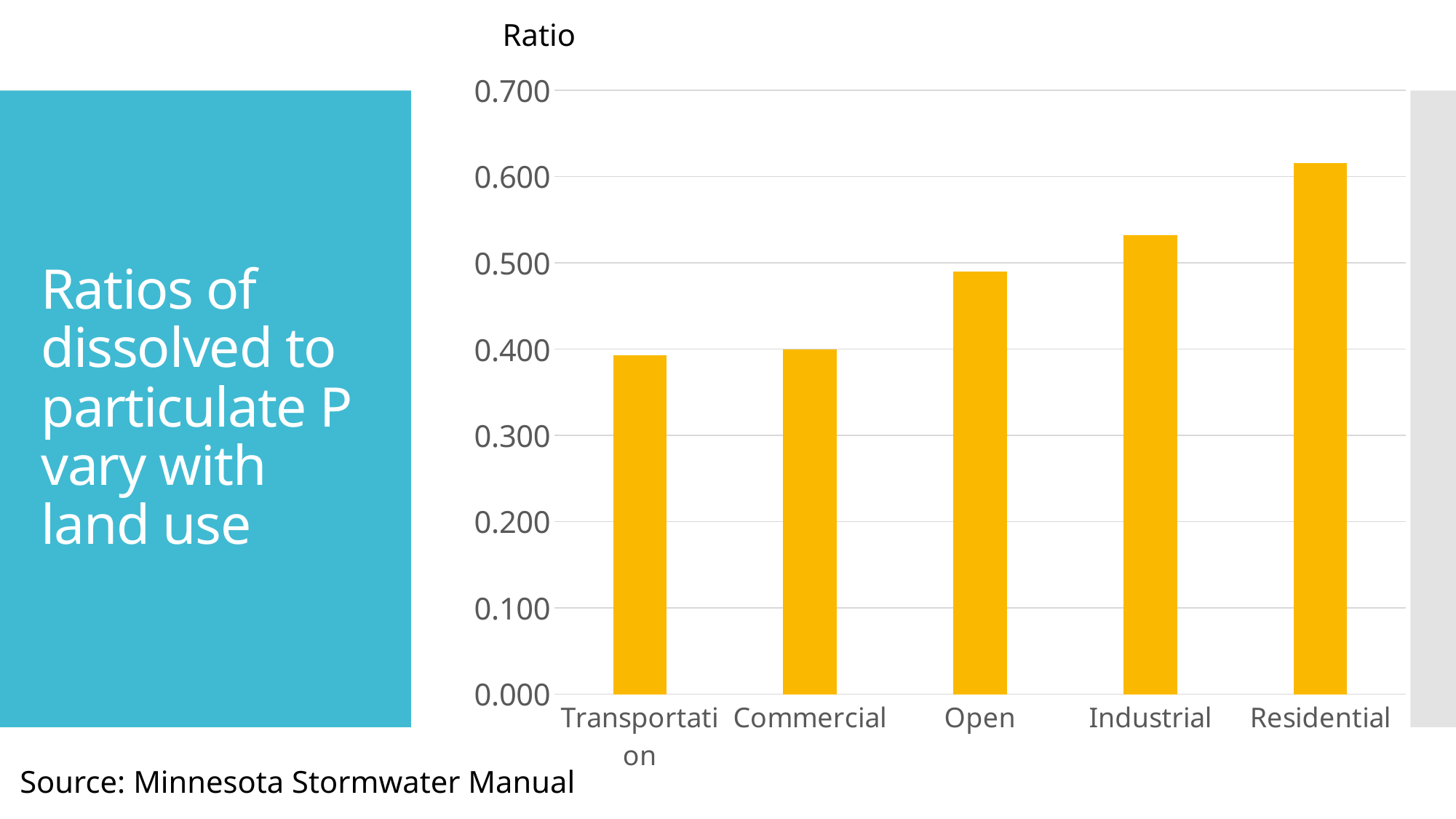
Which has a larger ratio, Residential or Open? Residential What is the label on the vertical axis of the chart? Ratio Is the value for Transportation greater or less than 0.500? less Is the value for Industrial greater or less than 0.500? greater Which land-use category has the highest ratio? Residential Is the value for Open greater or less than 0.400? greater Which has a larger ratio, Commercial or Industrial? Industrial What kind of chart is shown on the slide? bar chart How many land-use categories are plotted on the chart? 5 Do the values rise or fall moving from left to right across the categories? rise